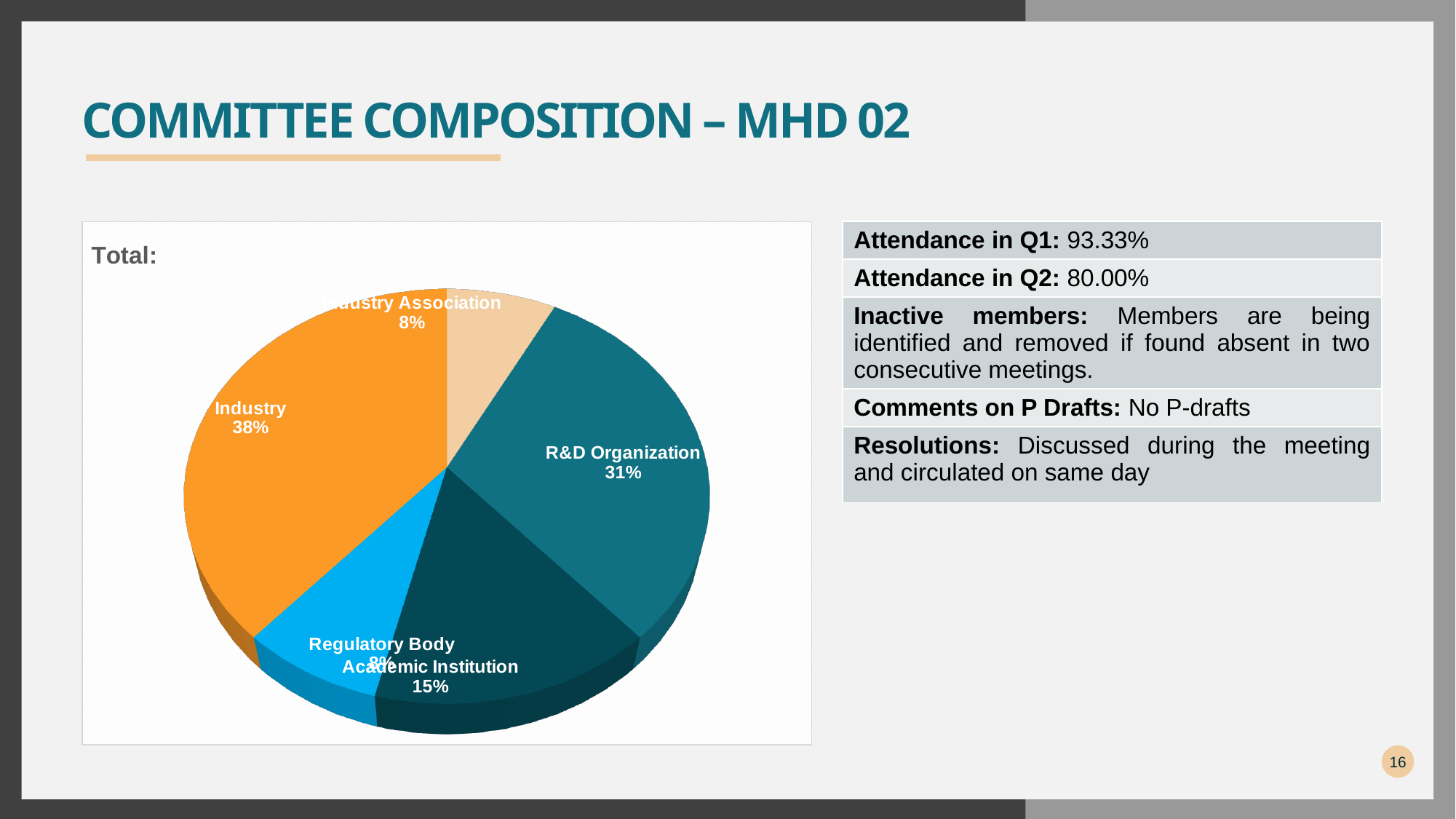
How many slices does the pie chart have? 5 By how many percentage points does R&D Organization exceed Academic Institution? 16 percentage points What percentage is shown for Industry Association? 8% What is the title shown at the top of the pie chart? Total: What share of the pie does the Industry slice represent? 38% By how many percentage points does Industry exceed R&D Organization? 7 percentage points What percentage is shown for Academic Institution? 15% Which category has the largest slice of the pie? Industry What kind of chart is shown on the slide? pie chart Which is larger, the Industry slice or the Industry Association slice? Industry Which is larger, the R&D Organization slice or the Academic Institution slice? R&D Organization What percentage is shown for R&D Organization? 31%